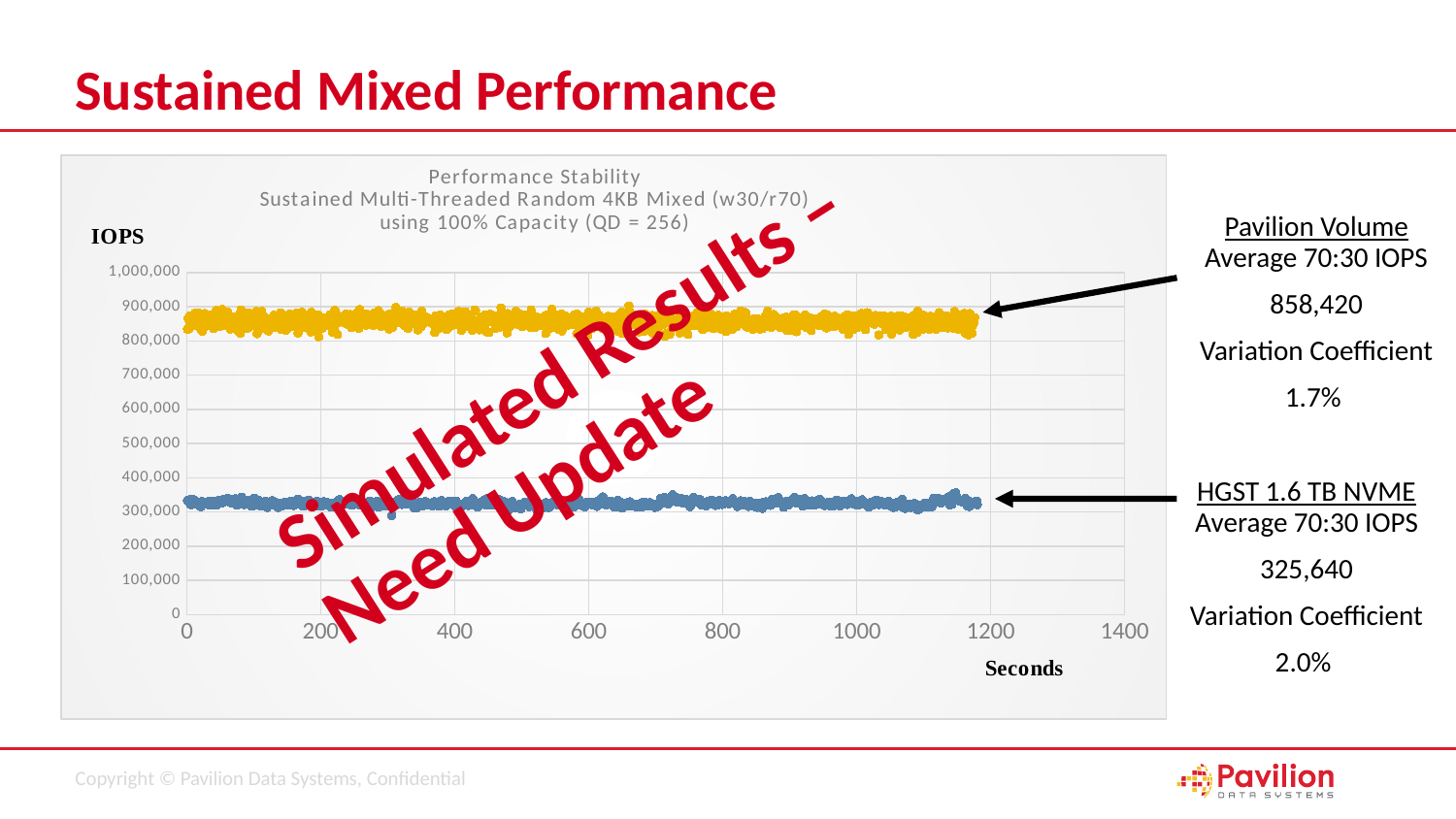
What is the average 70:30 IOPS stated for the Pavilion Volume? 858,420 What is the label of the x axis of the chart? Seconds Which series has higher IOPS values, Pavilion Volume or HGST 1.6 TB NVME? Pavilion Volume Is the IOPS value for the HGST 1.6 TB NVME series greater or less than 400,000? less Do the IOPS values for the Pavilion Volume series rise, fall, or stay roughly flat as seconds increase? stay roughly flat What is the variation coefficient stated for the HGST 1.6 TB NVME? 2.0% What kind of chart is shown on the slide? scatter chart Is the IOPS value for the HGST 1.6 TB NVME series greater or less than 300,000? greater What is the average 70:30 IOPS stated for the HGST 1.6 TB NVME? 325,640 Is the IOPS value for the Pavilion Volume series greater or less than 800,000? greater What is the difference between the stated average IOPS of the Pavilion Volume and the HGST 1.6 TB NVME? 532,780 What is the highest tick value shown on the y axis of the chart? 1,000,000